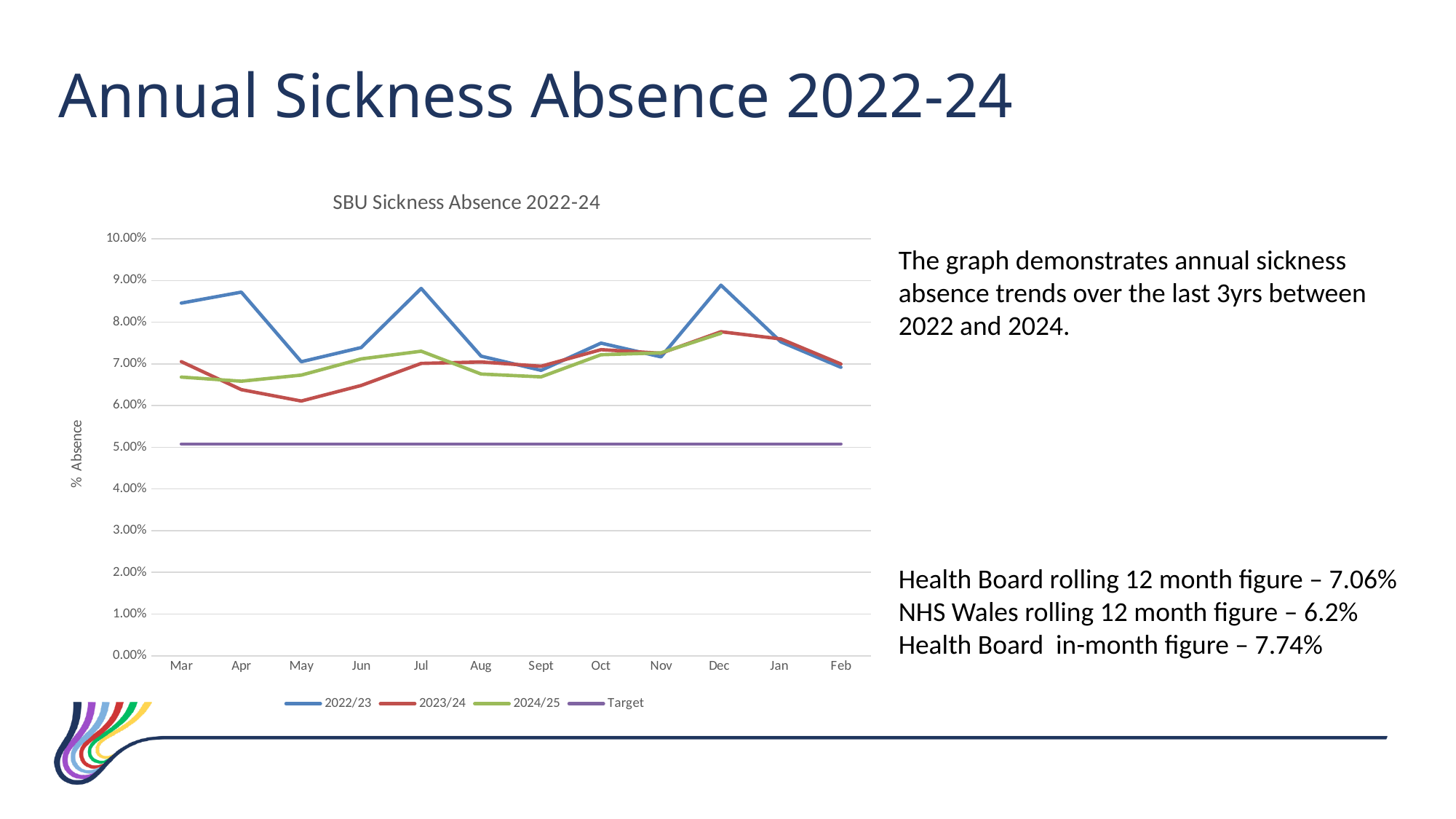
Is the value for 2022/23 in Apr greater or less than 8.00%? greater In which month does the 2023/24 series reach its lowest value? May How many series does the legend of the chart list? 4 Is the Target line greater or less than 6.00%? less What is the title of the chart? SBU Sickness Absence 2022-24 In Jul, which series has the higher value, 2022/23 or 2024/25? 2022/23 What kind of chart is shown on the slide? line chart How many months are shown along the x axis of the chart? 12 Does the 2022/23 series rise or fall from Dec to Feb? fall In Mar, which series has the higher value, 2022/23 or 2023/24? 2022/23 What is the label on the y axis of the chart? % Absence Is the value for 2023/24 in May greater or less than 7.00%? less